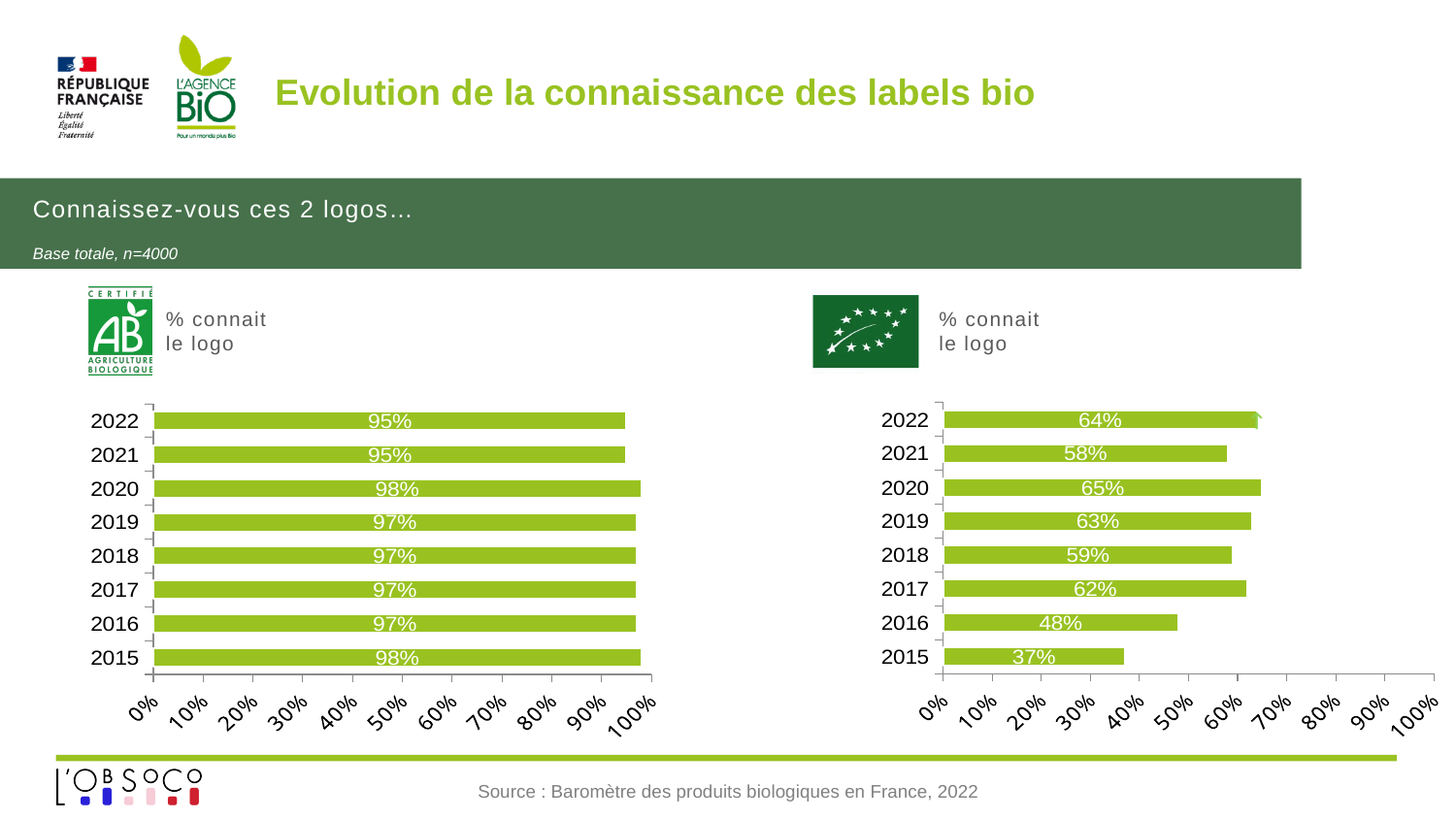
In the right chart (EU leaf logo), which year has the highest value? 2020 How many years are shown in the left chart (AB logo)? 8 In the left chart (AB logo), is the value for 2019 greater or less than 90%? greater In the right chart (EU leaf logo), what percentage knew the logo in 2015? 37% In the left chart (AB logo), what percentage knew the logo in 2022? 95% In the right chart (EU leaf logo), which year has the lowest value? 2015 In the left chart (AB logo), what is the difference between the 2020 value and the 2021 value? 3% What type of chart is used on the right side of the slide? Bar chart In the right chart (EU leaf logo), what is the difference between the 2022 value and the 2015 value? 27% In the right chart (EU leaf logo), which is larger, the value for 2016 or the value for 2017? 2017 In the right chart (EU leaf logo), did the value rise or fall from 2015 to 2016? Rise In the right chart (EU leaf logo), what is the value for 2021? 58%